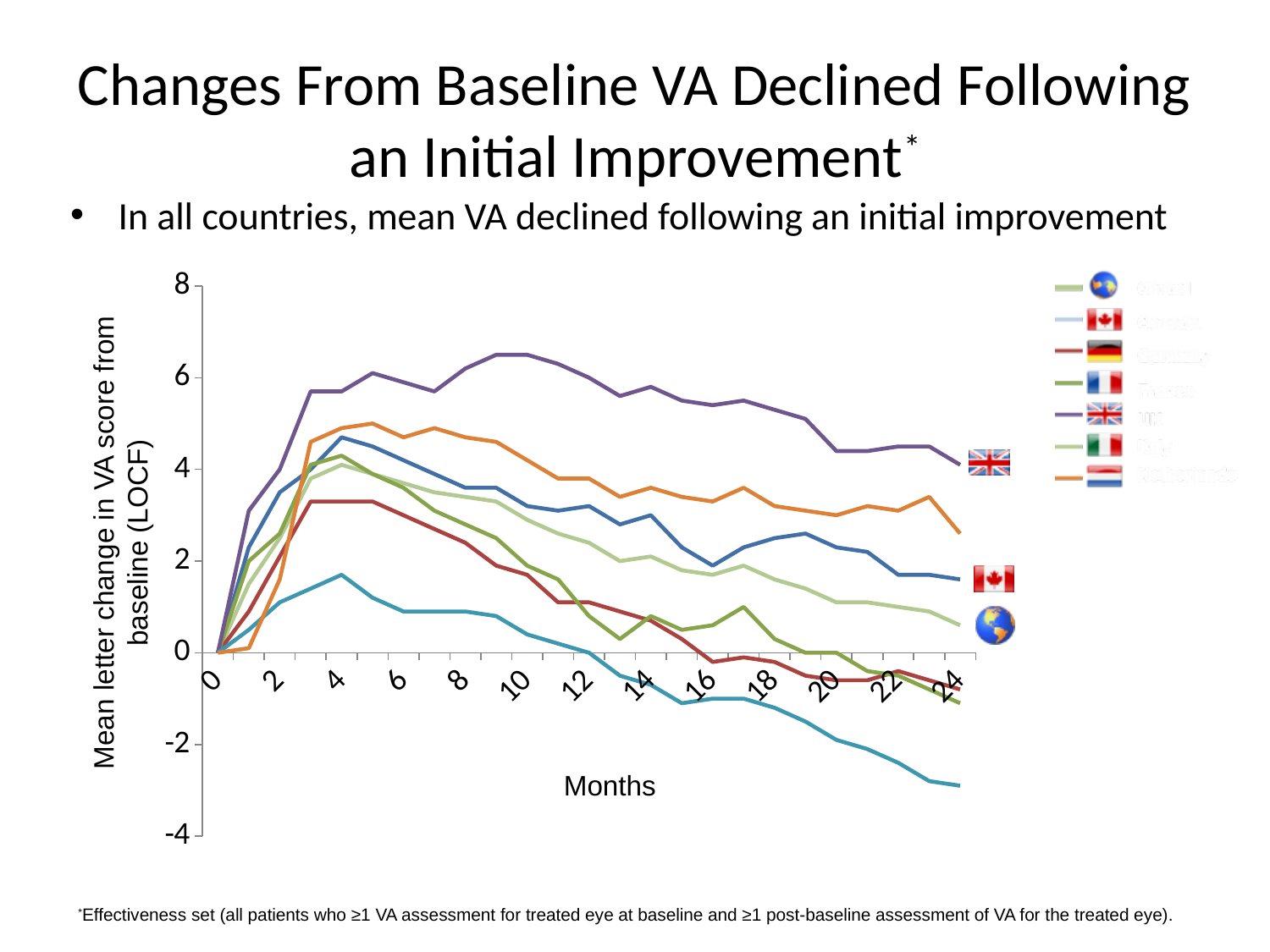
Which line reaches the highest value on the chart: the one marked with the UK flag, the Canadian flag, or the globe? the UK flag line After their initial rise, do the lines generally rise or fall from about month 10 to month 24? fall At month 24, which is larger: the value of the line marked with the UK flag or the line marked with the globe? the UK flag line How many month labels are shown along the x axis? 13 Is the value of the line marked with the Canadian flag at month 24 greater or less than 2? less Is the value of the line marked with the globe at month 24 greater or less than -2? greater Is the value of the line marked with the UK flag at month 10 greater or less than 6? greater Which line ends lowest at month 24: the one marked with the UK flag, the Canadian flag, or the globe? the globe line How many series does the legend list? 7 What is the label of the x axis? Months What kind of chart is shown on the slide? line chart What is the label of the y axis? Mean letter change in VA score from baseline (LOCF)